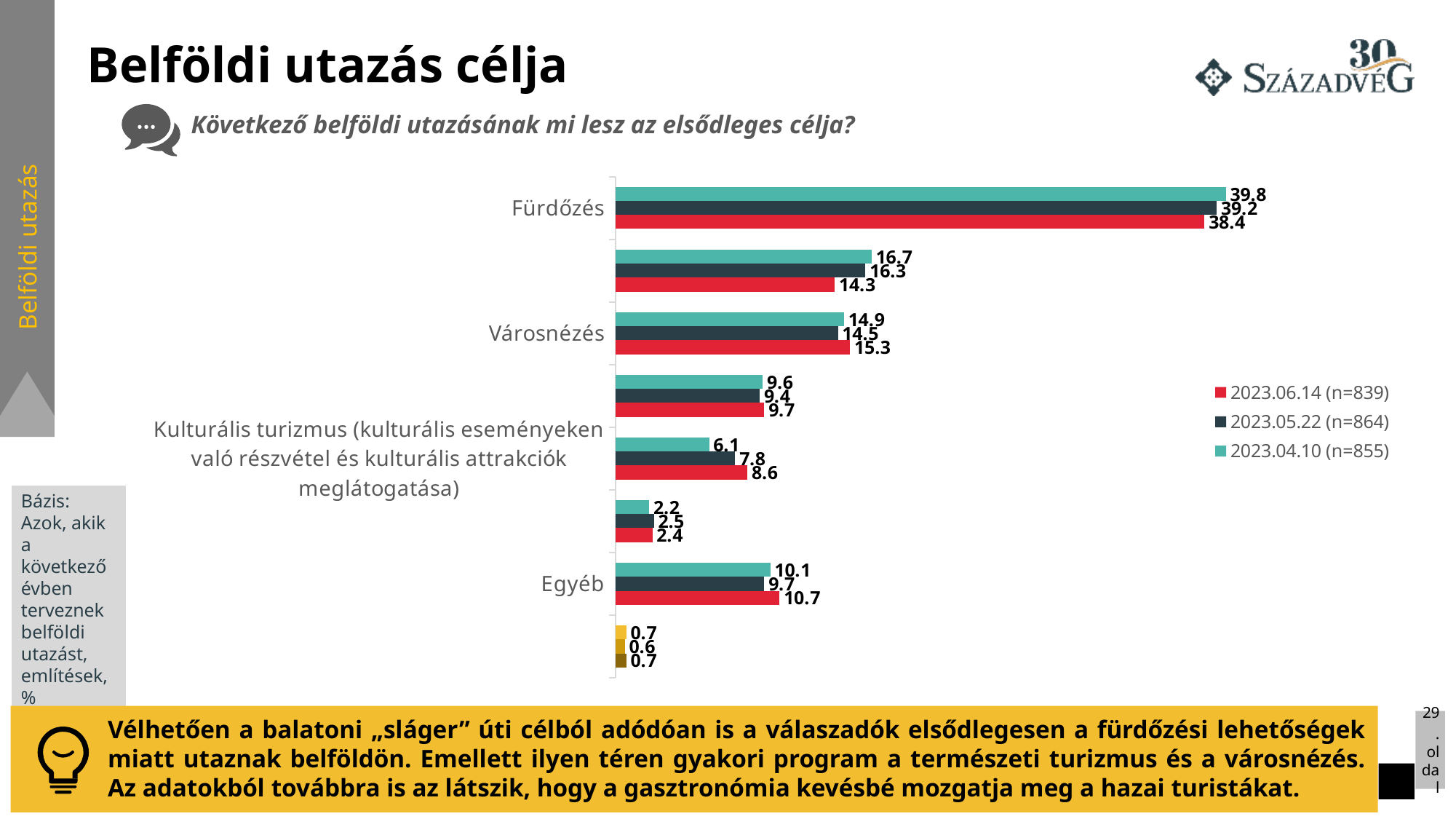
Which series is shown in red in the legend? 2023.06.14 (n=839) Which category has the highest values across all series? Fürdőzés What is the value for Kulturális turizmus in the 2023.04.10 (n=855) series? 6.1 What is the difference between the 2023.06.14 and 2023.04.10 values for Kulturális turizmus? 2.5 For Városnézés, which series has the larger value: 2023.06.14 or 2023.04.10? 2023.06.14 What is the value for Fürdőzés in the 2023.04.10 (n=855) series? 39.8 What is the value for Városnézés in the 2023.05.22 (n=864) series? 14.5 What is the value for Fürdőzés in the 2023.06.14 (n=839) series? 38.4 How many series does the legend list? 3 What kind of chart is shown on the slide? bar chart What is the value for Egyéb in the 2023.06.14 (n=839) series? 10.7 What is the difference between the 2023.04.10 and 2023.06.14 values for Fürdőzés? 1.4